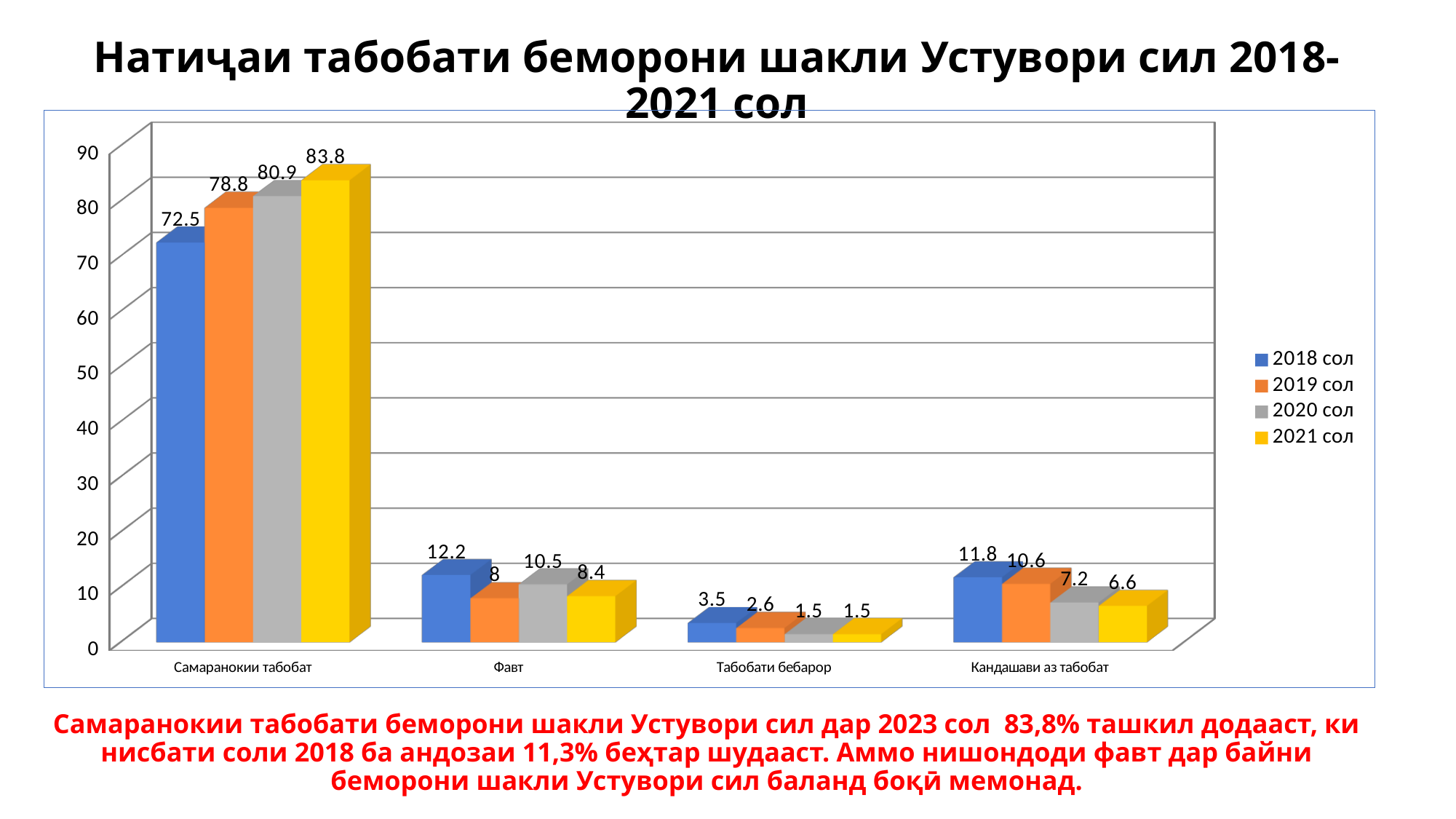
What is the value for Самаранокии табобат in the 2021 сол series? 83.8 What is the difference between the 2021 сол and 2018 сол values for Самаранокии табобат? 11.3 How many categories are shown on the x axis? 4 How many series does the legend list? 4 Do the values for Кандашави аз табобат rise or fall from 2018 сол to 2021 сол? fall Which category has the lowest value in the 2018 сол series? Табобати бебарор Which year has the highest value for Самаранокии табобат? 2021 сол What kind of chart is shown on the slide? bar chart Which is larger for Фавт: the 2019 сол value or the 2020 сол value? 2020 сол What is the value for Кандашави аз табобат in the 2020 сол series? 7.2 What is the value for Фавт in the 2018 сол series? 12.2 What is the value for Табобати бебарор in the 2019 сол series? 2.6